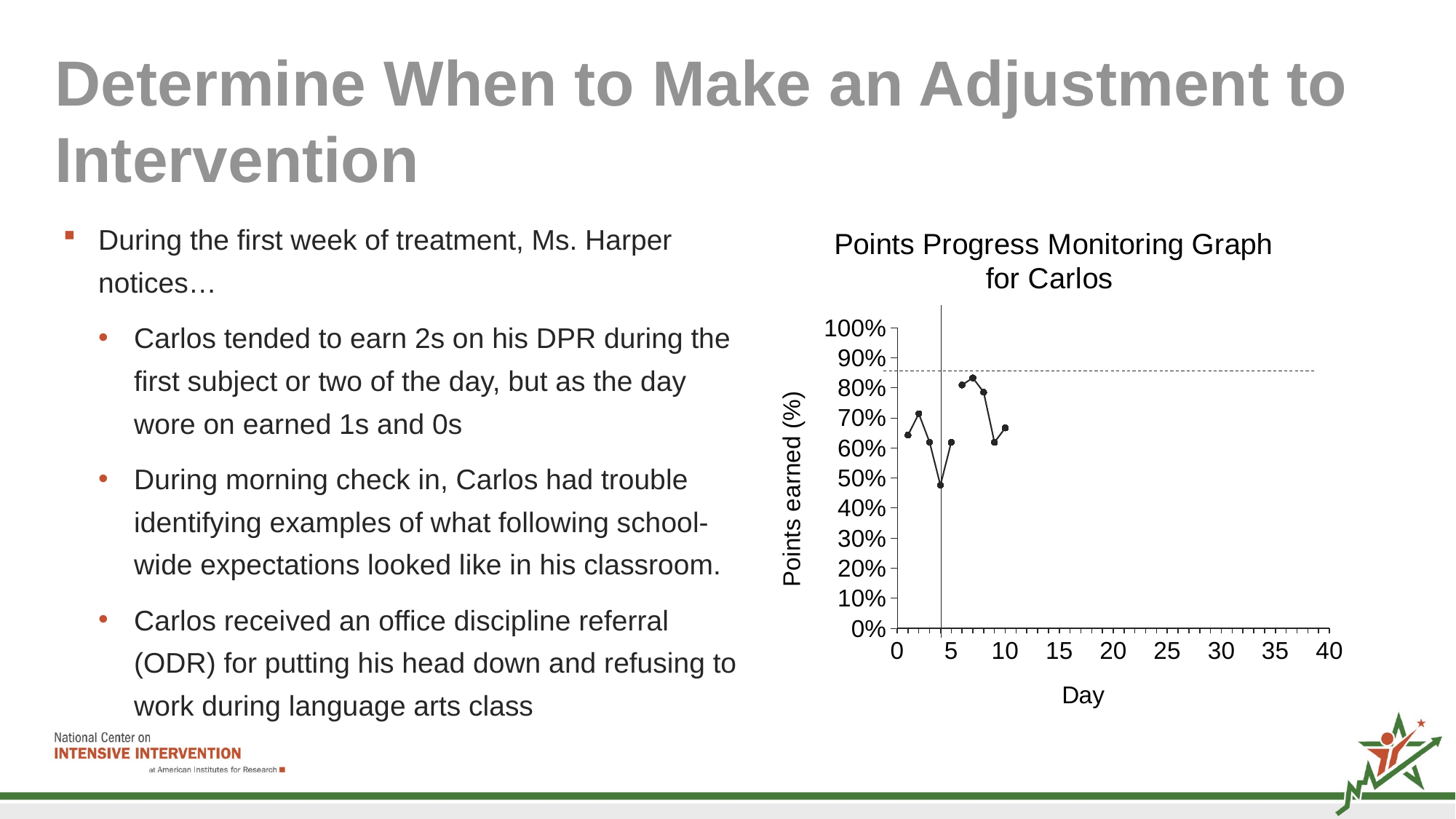
What is the title of the x axis on the chart? Day Is the value for Day 1 greater or less than 60%? greater What is the title of the y axis on the chart? Points earned (%) Which day has the larger points earned value, Day 4 or Day 7? Day 7 What kind of chart is the Points Progress Monitoring Graph for Carlos? line chart How many data points are plotted on the Points Progress Monitoring Graph for Carlos? 10 Is the value for Day 7 greater or less than 80%? greater On which day is Carlos's points earned value lowest? Day 4 Do the values rise or fall from Day 4 to Day 7? rise Is the value for Day 10 greater or less than 70%? less